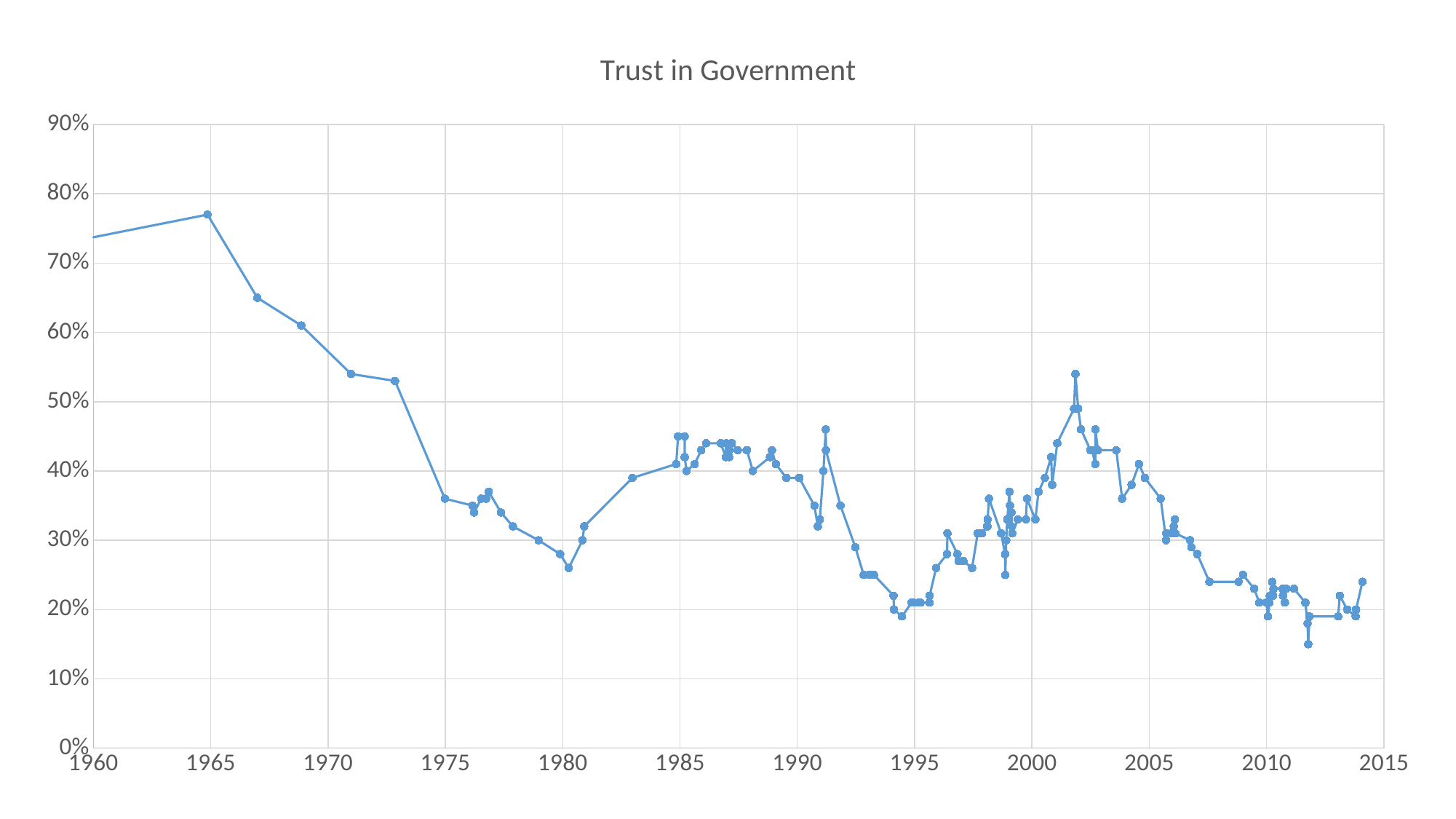
Which year has the higher value, 1965 or 2010? 1965 Overall, do the values rise or fall from 1960 to 2014? fall In which year does the chart reach its highest value? 1965 How many data series (lines) are plotted on the chart? 1 Is the value for 1965 greater or less than 70%? greater Which year has the higher value, 1975 or 1986? 1986 What kind of chart is shown on the slide? line chart What is the title of the chart? Trust in Government Is the value for 1980 greater or less than 30%? less Is the value for 1975 greater or less than 30%? greater